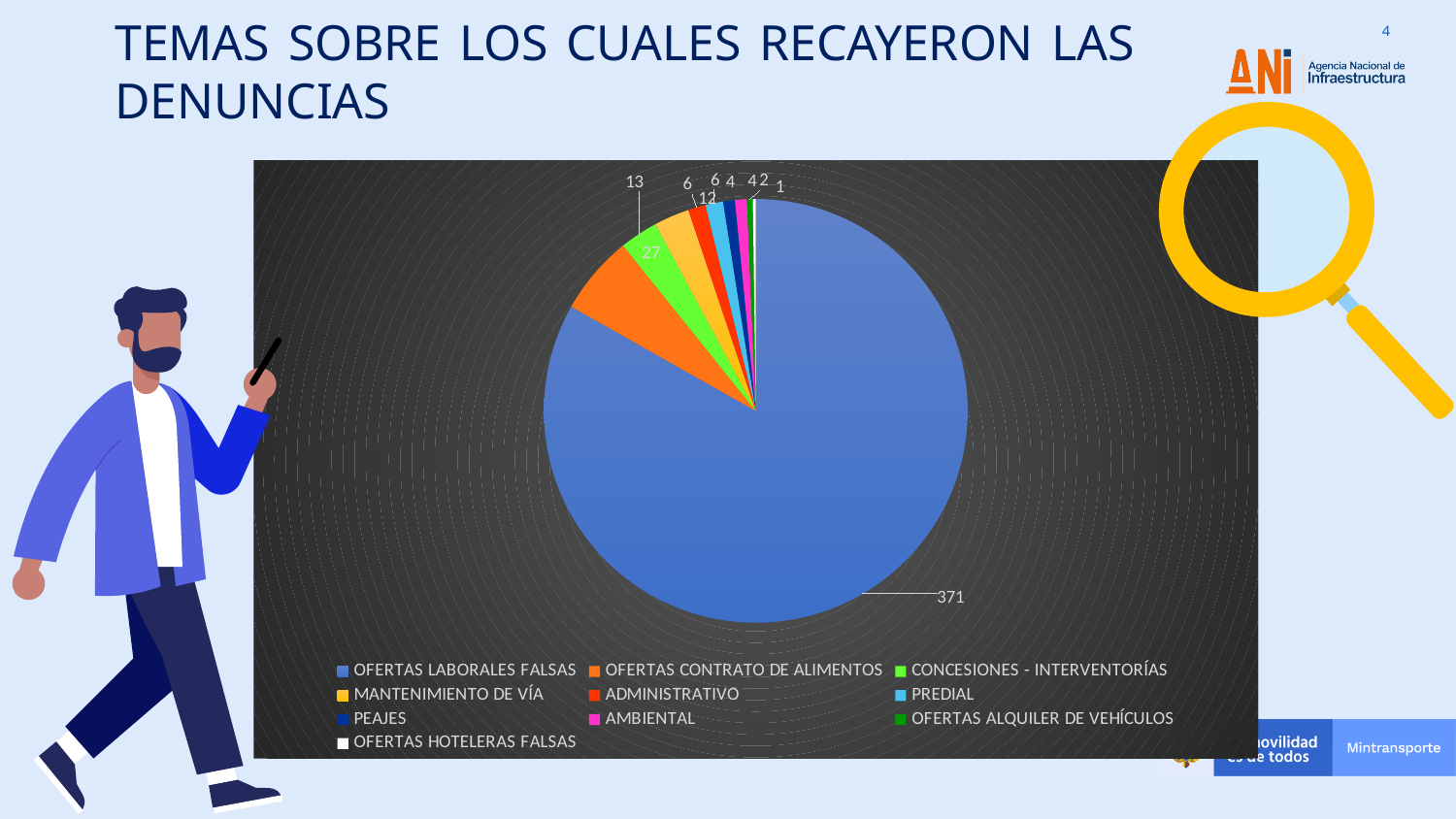
Which is larger, the value for OFERTAS CONTRATO DE ALIMENTOS or the value for CONCESIONES - INTERVENTORÍAS? OFERTAS CONTRATO DE ALIMENTOS What is the value for OFERTAS CONTRATO DE ALIMENTOS? 27 Which category has the largest slice of the pie? OFERTAS LABORALES FALSAS What is the value for MANTENIMIENTO DE VÍA? 12 What is the value for OFERTAS LABORALES FALSAS? 371 What is the value for CONCESIONES - INTERVENTORÍAS? 13 How many categories does the pie chart have? 10 What colour is the slice for OFERTAS LABORALES FALSAS? blue What is the difference between the values for OFERTAS LABORALES FALSAS and OFERTAS CONTRATO DE ALIMENTOS? 344 What kind of chart is shown on the slide? pie chart Which category has the smallest slice of the pie? OFERTAS HOTELERAS FALSAS What is the title of the slide containing the chart? TEMAS SOBRE LOS CUALES RECAYERON LAS DENUNCIAS